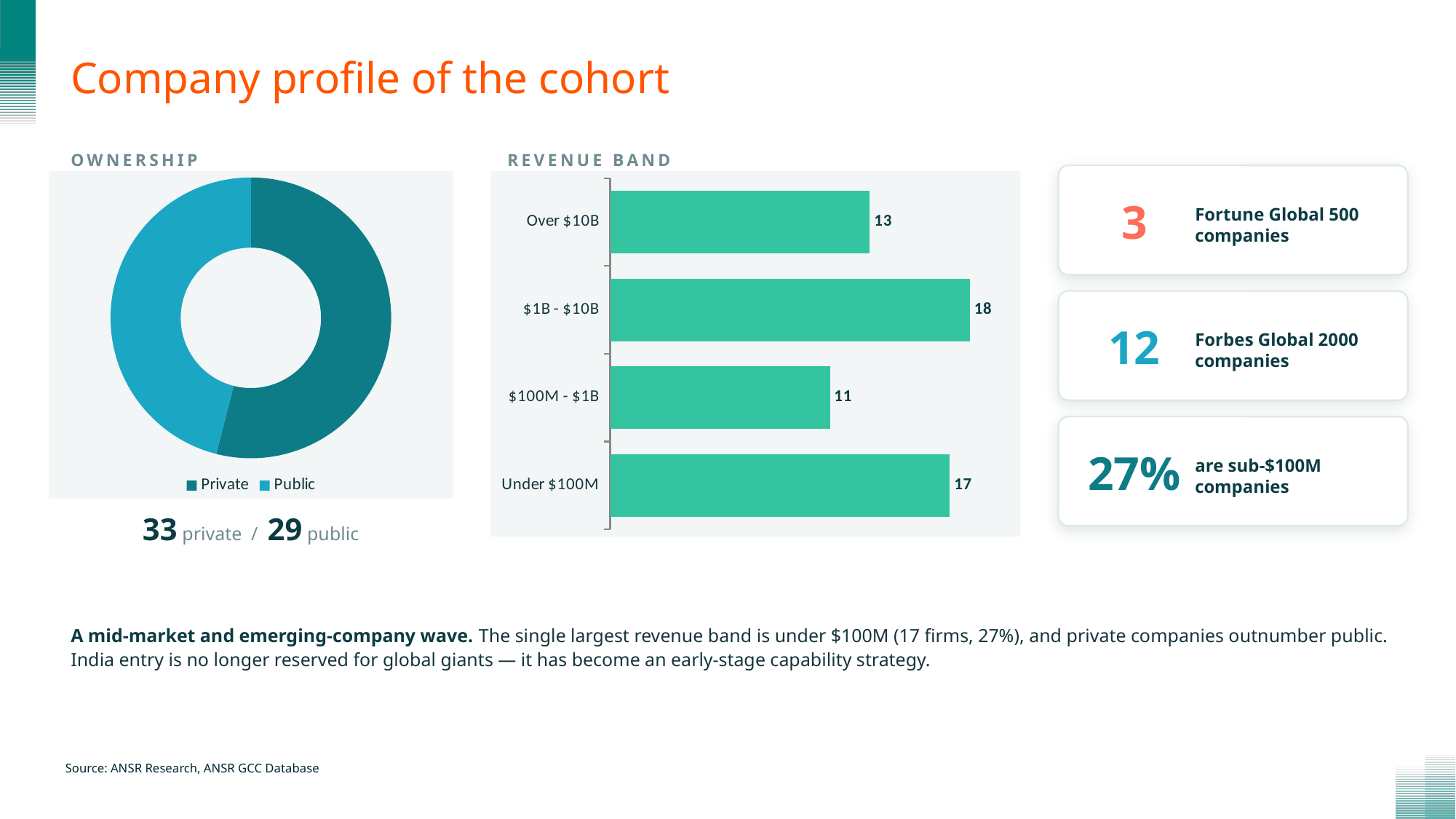
In the Ownership chart, which segment is larger: Private or Public? Private How many entries does the legend of the Ownership chart list? 2 How many revenue bands are shown in the Revenue Band chart? 4 In the Revenue Band chart, what is the value for Under $100M? 17 What type of chart is the Revenue Band chart? Bar chart In the Revenue Band chart, which revenue band has the highest value? $1B - $10B In the Ownership chart, how many companies are private? 33 In the Revenue Band chart, what is the difference between the $1B - $10B band and the $100M - $1B band? 7 In the Revenue Band chart, which is larger: Under $100M or Over $10B? Under $100M In the Revenue Band chart, how many companies are in the $1B - $10B band? 18 In the Revenue Band chart, which revenue band has the lowest value? $100M - $1B In the Revenue Band chart, what is the value for Over $10B? 13